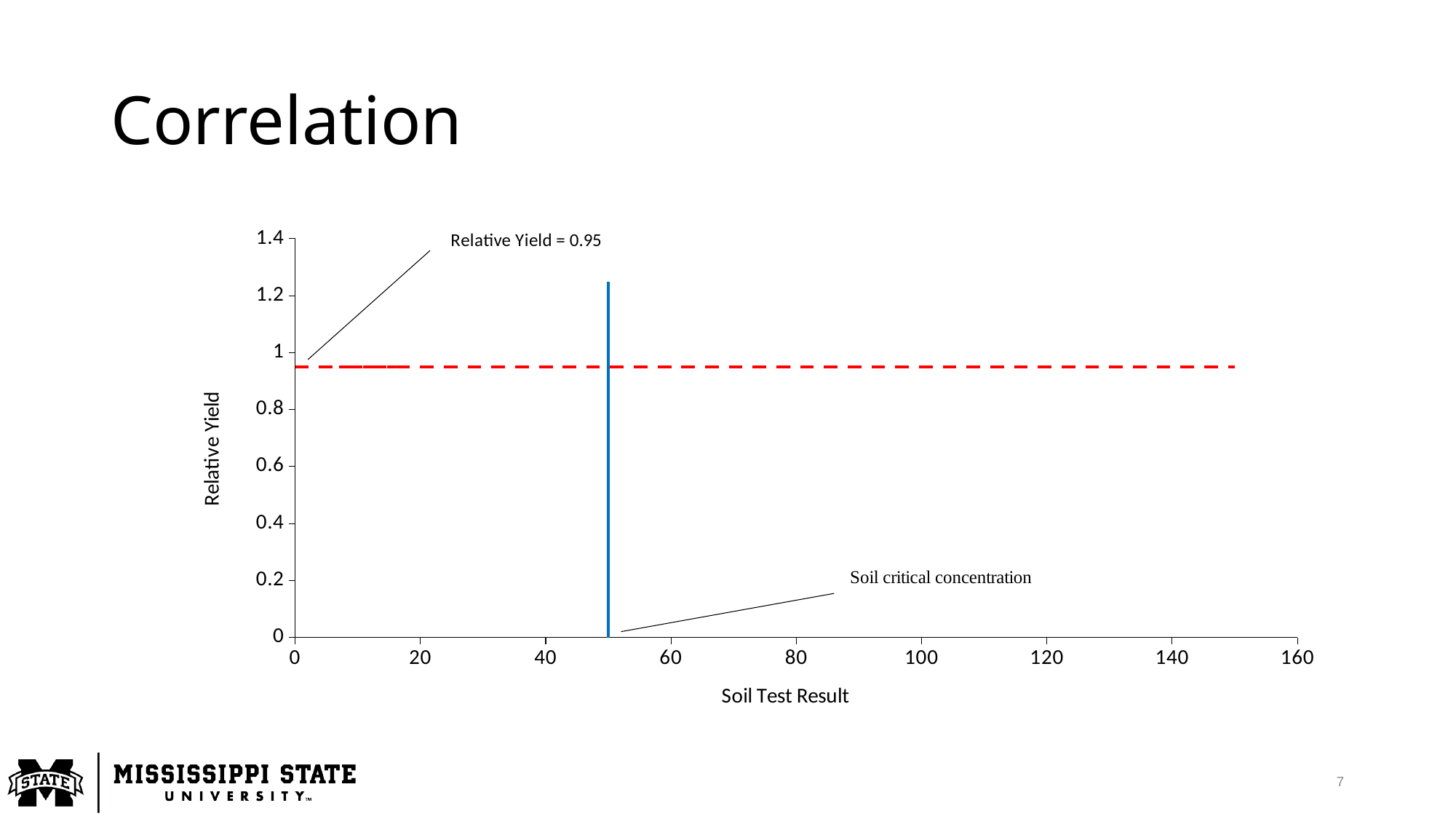
What is the label of the x axis? Soil Test Result Is the Soil Test Result at the vertical blue line (soil critical concentration) greater or less than 40? greater What Relative Yield value does the dashed red horizontal line mark? 0.95 What is the label of the y axis? Relative Yield Is the Soil Test Result at the vertical blue line (soil critical concentration) greater or less than 60? less Is the Relative Yield marked by the dashed red line greater or less than 0.8? greater What does the vertical blue line represent, according to its annotation? Soil critical concentration